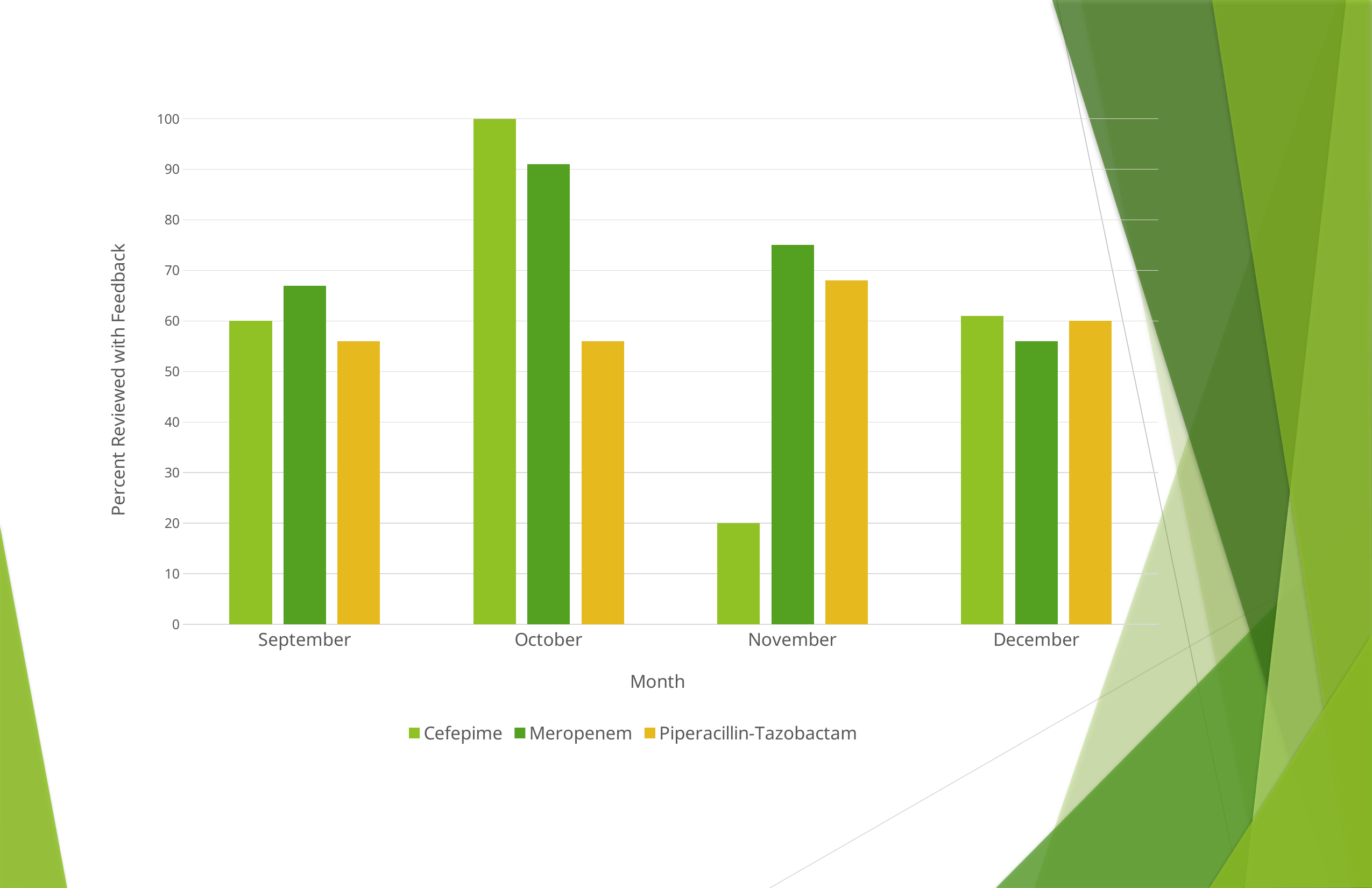
In which month is the Cefepime value lowest? November What is the value for Cefepime in September? 60 What is the value for Cefepime in October? 100 What kind of chart is shown on the slide? bar chart Is the value for Piperacillin-Tazobactam in September greater or less than 60? less Is the value for Meropenem in October greater or less than 80? greater How many months are shown on the x axis? 4 What is the value for Cefepime in November? 20 How many series does the legend list? 3 In November, which is larger: the Meropenem value or the Cefepime value? Meropenem In which month is the Cefepime value highest? October What is the label of the y axis? Percent Reviewed with Feedback